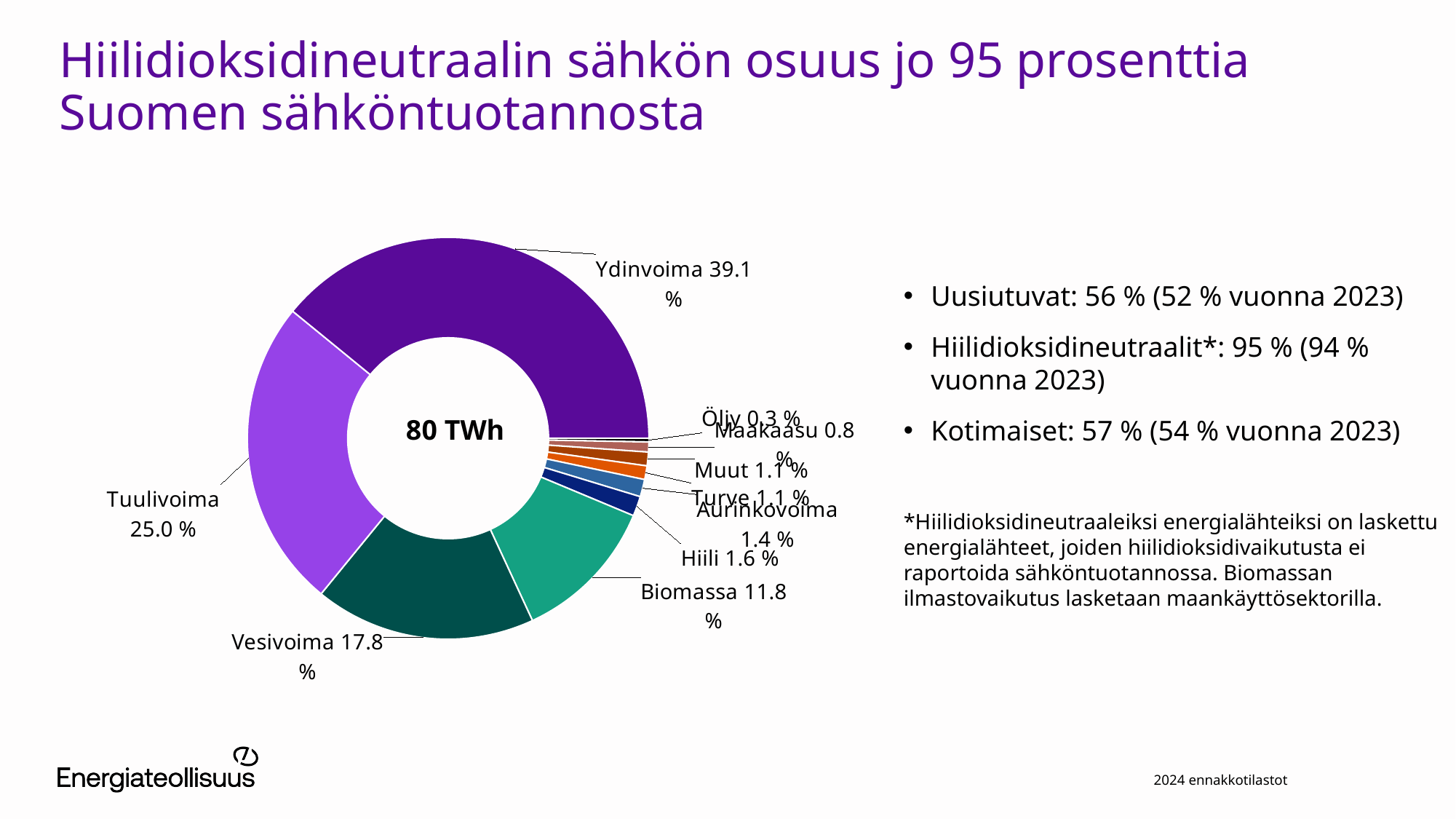
What is the value shown for Biomassa? 11.8 % What is the value shown for Hiili? 1.6 % Which category has the smallest slice in the chart? Öljy What kind of chart is shown on the slide? Pie chart (donut) How many categories are shown in the chart? 10 What is the difference between the shares of Ydinvoima and Tuulivoima? 14.1 % Which category has the largest slice in the chart? Ydinvoima What share of the pie chart does Ydinvoima have? 39.1 % What is the value shown for Tuulivoima? 25.0 % What total is printed in the centre of the chart? 80 TWh What is the value shown for Vesivoima? 17.8 % Which is larger, the share of Vesivoima or the share of Biomassa? Vesivoima